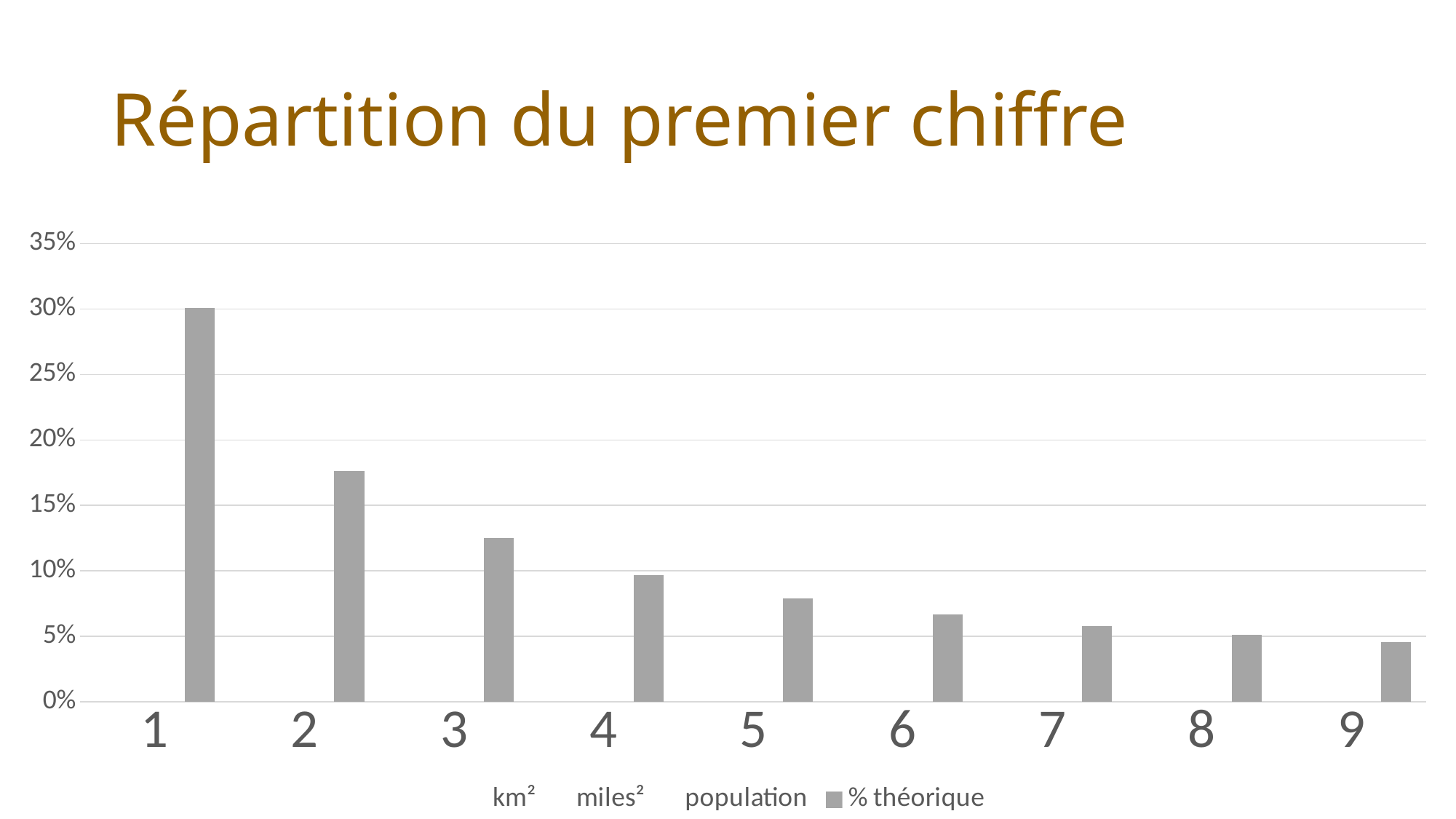
Do the bar values rise or fall as the digit increases from 1 to 9? fall Is the value for digit 3 greater or less than 10%? greater Which first digit has the lowest bar in the chart? 9 Is the value for digit 2 greater or less than 20%? less Is the value for digit 1 greater or less than 25%? greater How many entries does the chart's legend list? 4 How many categories are shown on the x axis of the chart? 9 Which first digit has the highest bar in the chart? 1 What kind of chart is shown on the slide? bar chart Which has a larger value, digit 4 or digit 7? 4 What is the title of the chart on the slide? Répartition du premier chiffre